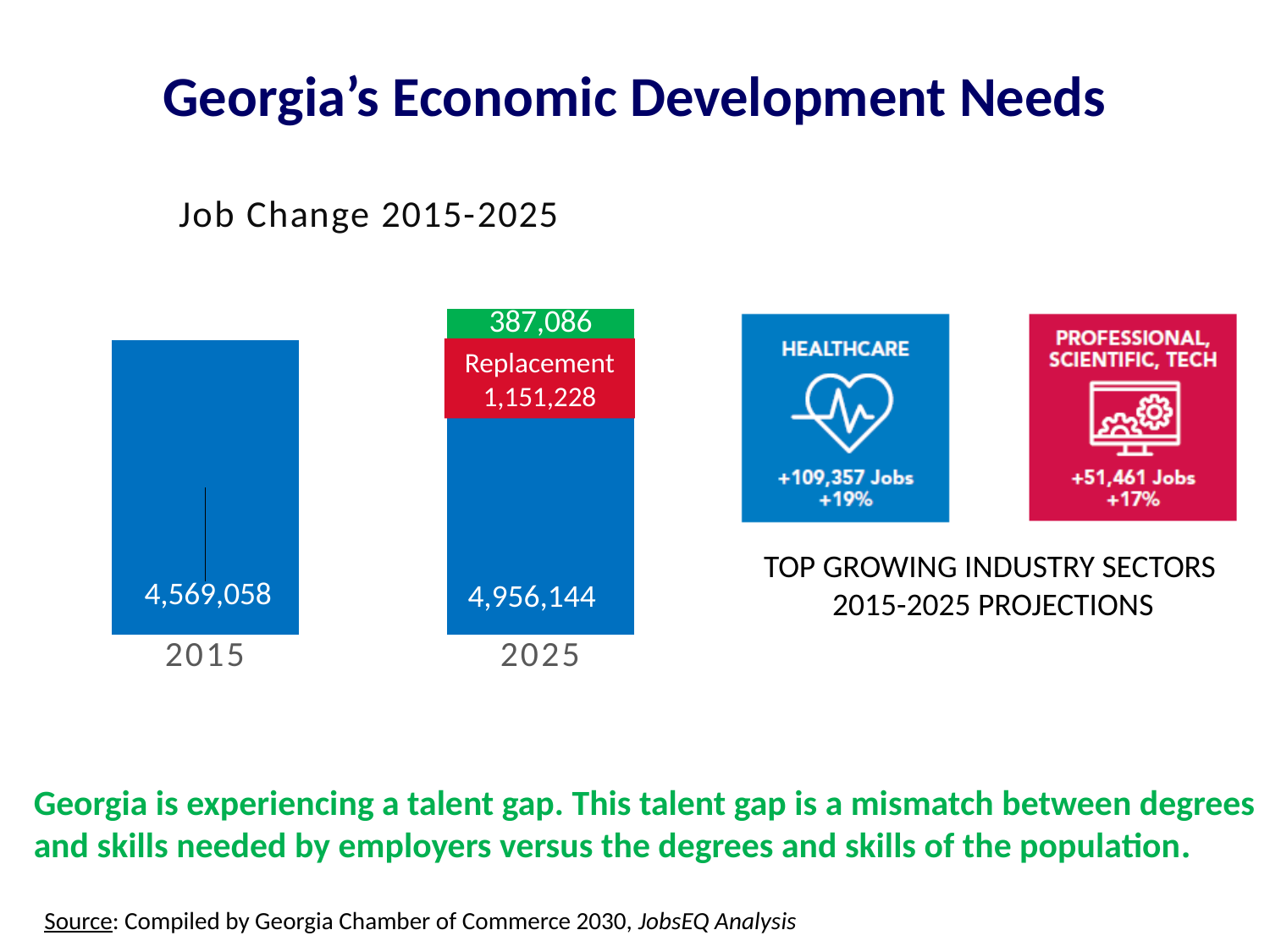
How many years (categories) are shown on the x axis of the Job Change 2015-2025 chart? 2 In the Job Change 2015-2025 chart, what value is shown for 2015? 4,569,058 In the Job Change 2015-2025 chart, what value is shown in the green segment at the top of the 2025 bar? 387,086 In the Job Change 2015-2025 chart, do the blue bar values rise or fall from 2015 to 2025? Rise In the Job Change 2015-2025 chart, what is the difference between the blue 2025 value (4,956,144) and the 2015 value (4,569,058)? 387,086 In the Job Change 2015-2025 chart, what value is shown for the Replacement segment of the 2025 bar? 1,151,228 In the Job Change 2015-2025 chart, what is the total of all three segments of the 2025 stacked bar? 6,494,458 What kind of chart is the Job Change 2015-2025 chart? Bar chart In the Job Change 2015-2025 chart, which is larger: the 2015 value or the blue segment of the 2025 bar? 2025 In the Job Change 2015-2025 chart, what colour is the Replacement segment? Red In the Job Change 2015-2025 chart, what value is shown in the blue segment of the 2025 bar? 4,956,144 In the Job Change 2015-2025 chart, what is the difference between the Replacement segment (1,151,228) and the green segment (387,086)? 764,142